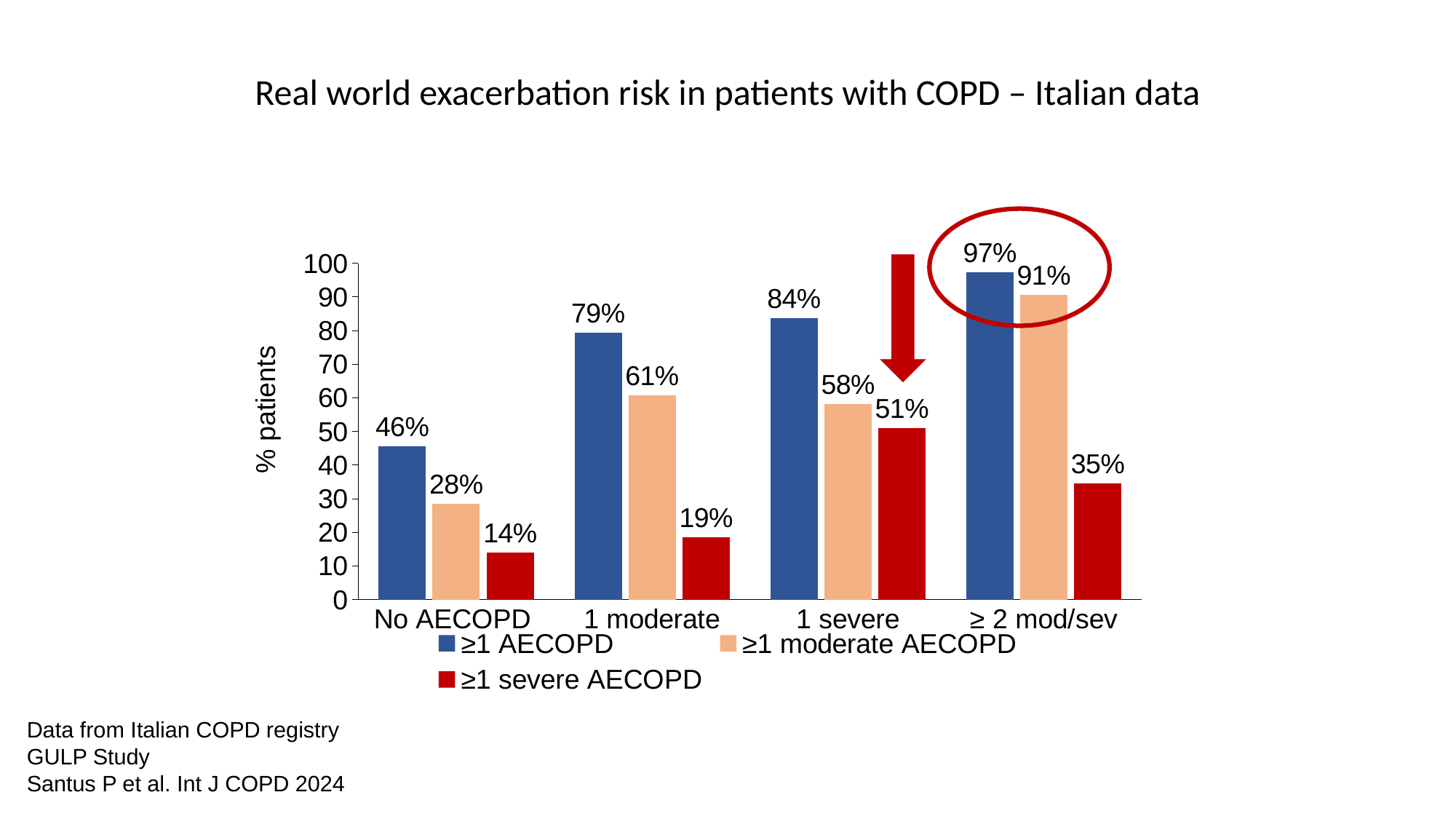
How many categories are shown on the x axis? 4 What is the y-axis label of the chart? % patients Which is larger: ≥1 severe AECOPD in the 1 severe category or ≥1 severe AECOPD in the ≥ 2 mod/sev category? 1 severe How many series does the legend list? 3 What is the value for ≥1 moderate AECOPD in the ≥ 2 mod/sev category? 91% What is the value for ≥1 AECOPD in the No AECOPD category? 46% Which category has the lowest value for ≥1 severe AECOPD? No AECOPD Which category has the highest value for ≥1 AECOPD? ≥ 2 mod/sev What kind of chart is shown on the slide? Bar chart What is the value for ≥1 severe AECOPD in the 1 severe category? 51% Do the ≥1 AECOPD values rise or fall from left to right across the categories? Rise What is the difference between the ≥1 AECOPD and ≥1 moderate AECOPD values in the 1 moderate category? 18%